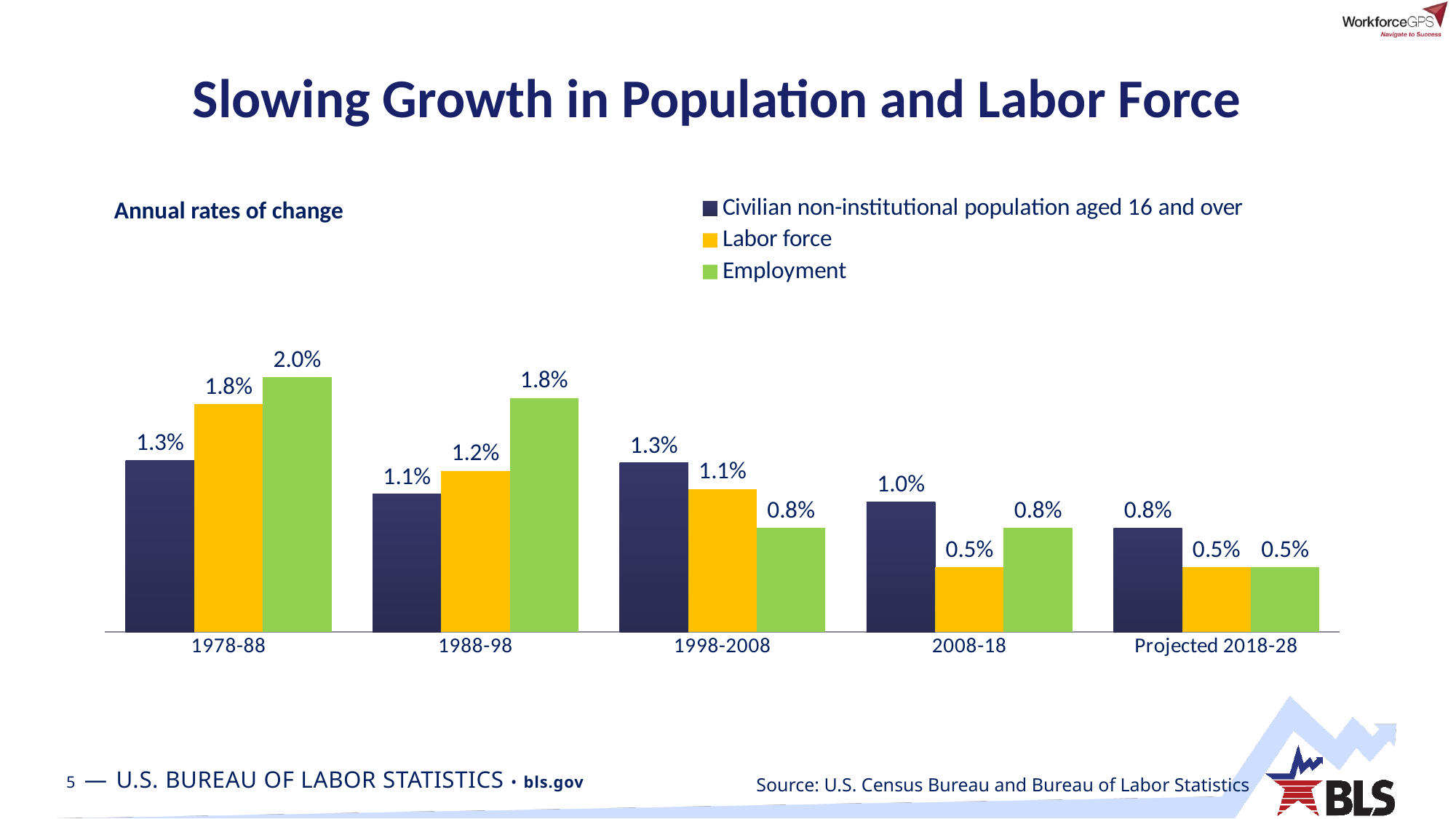
How many series does the legend list? 3 What kind of chart is shown on the slide? Bar chart Do the Employment rates of change rise or fall from 1978-88 to Projected 2018-28? Fall What is the difference between the Labor force rate of change in 1978-88 and in 2008-18? 1.3% Which period has the highest Employment rate of change? 1978-88 Which period has the lowest Civilian non-institutional population aged 16 and over rate of change? Projected 2018-28 What is the Employment annual rate of change for 1978-88? 2.0% Which colour represents Labor force in the chart? Yellow Which is larger in 1998-2008: the Civilian non-institutional population rate of change or the Employment rate of change? Civilian non-institutional population aged 16 and over What is the Labor force annual rate of change for 1988-98? 1.2% What is the Civilian non-institutional population aged 16 and over rate of change for Projected 2018-28? 0.8% How many time periods are shown on the x axis? 5